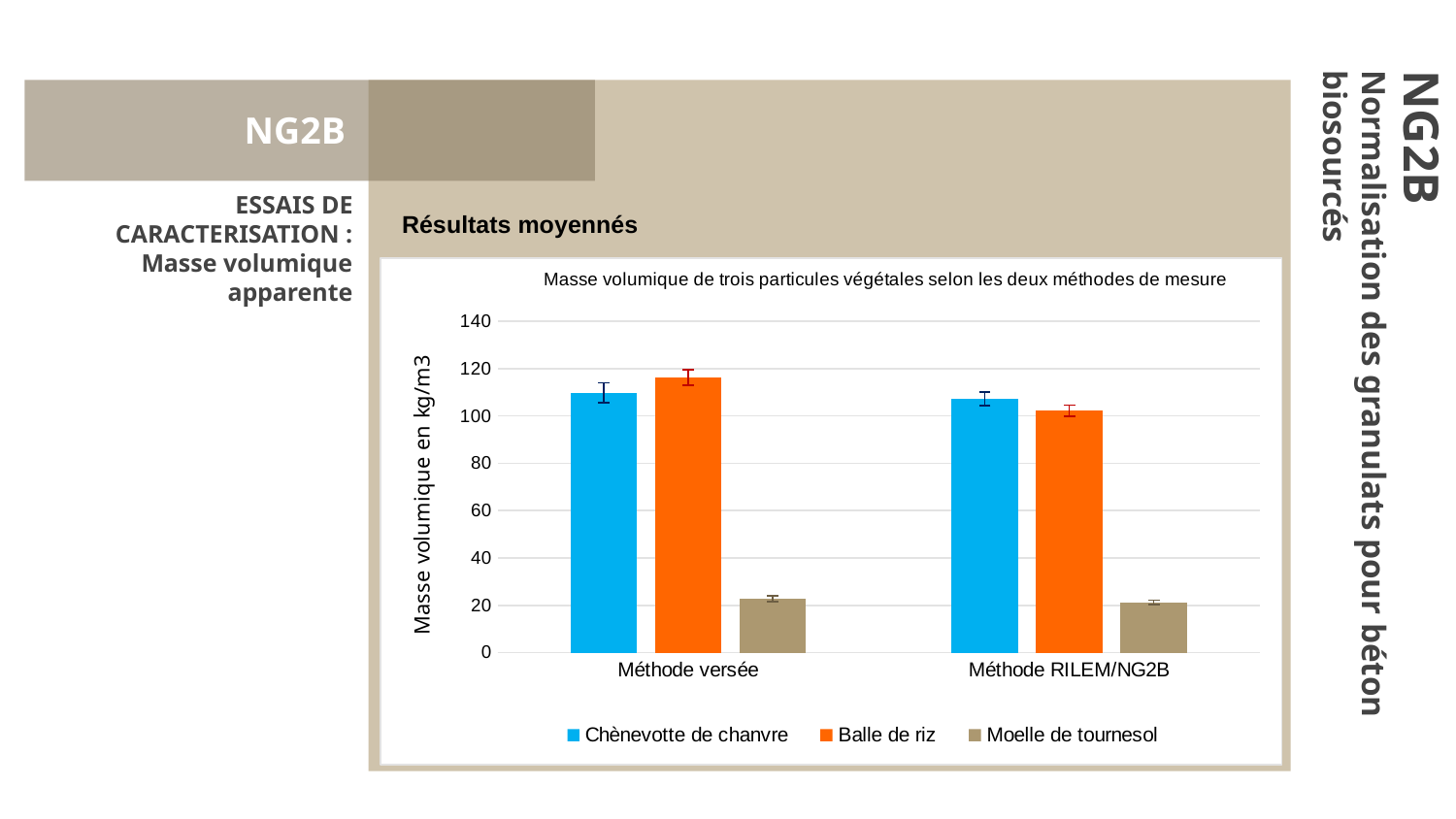
What is the label of the y axis? Masse volumique en kg/m3 For Méthode versée, which is larger: Balle de riz or Chènevotte de chanvre? Balle de riz How many measurement methods (categories) are shown on the x axis? 2 What is the title of the chart? Masse volumique de trois particules végétales selon les deux méthodes de mesure Is the value for Balle de riz with Méthode RILEM/NG2B greater or less than 120? less Which material has the lowest value for Méthode RILEM/NG2B? Moelle de tournesol How many series does the legend list? 3 Which material has the highest value for Méthode versée? Balle de riz Is the value for Chènevotte de chanvre with Méthode versée greater or less than 100? greater What kind of chart is shown on the slide? bar chart Is the value for Moelle de tournesol with Méthode RILEM/NG2B greater or less than 40? less Which material has the lowest value for Méthode versée? Moelle de tournesol